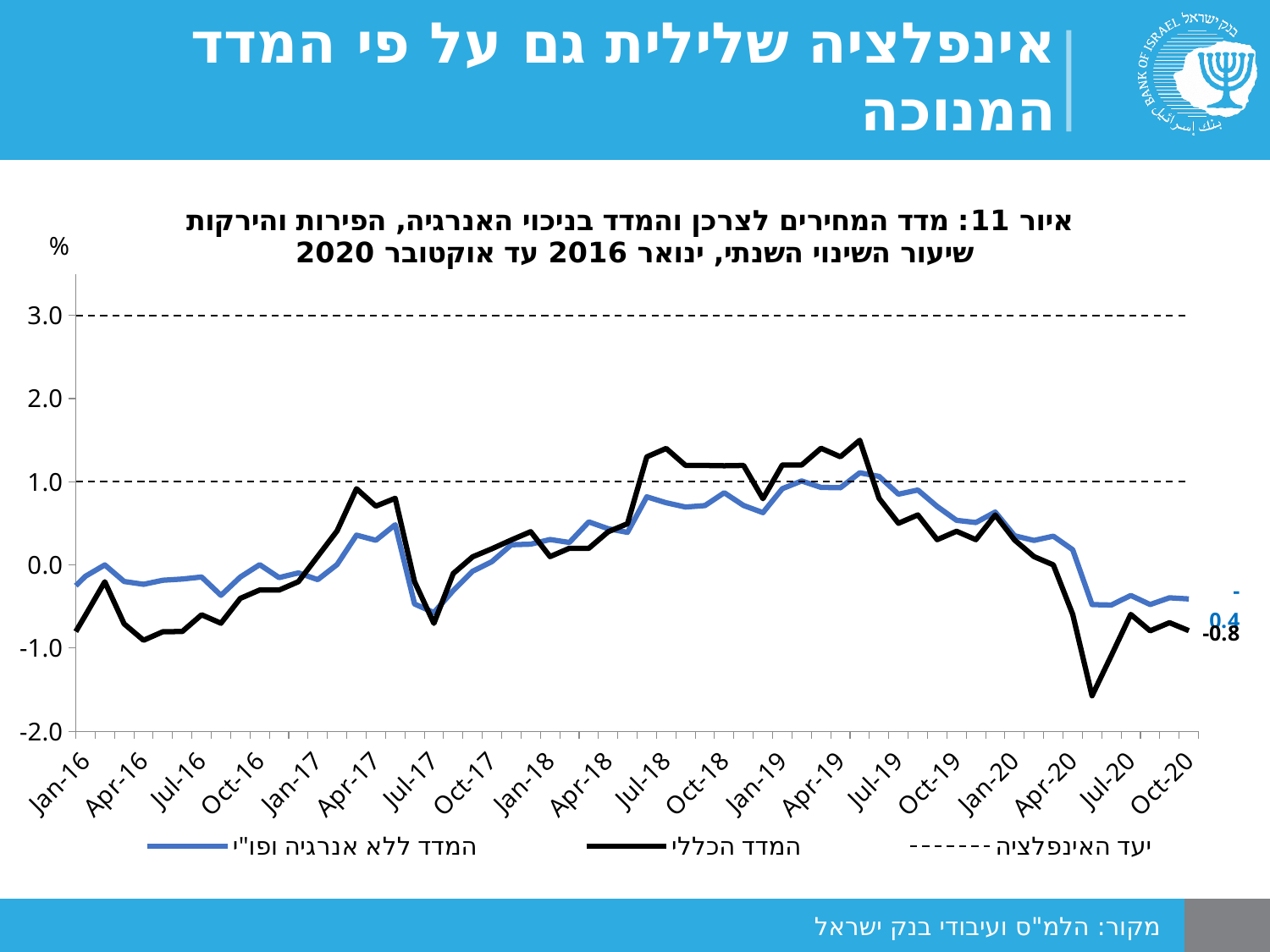
Between Jul-19 and Apr-20, does המדד הכללי generally rise or fall? fall What do the dashed horizontal lines at 1.0 and 3.0 represent, according to the legend? יעד האינפלציה What is the last labelled value of המדד ללא אנרגיה ופו"י (October 2020)? -0.4 What is the difference between the final labelled values of המדד ללא אנרגיה ופו"י (-0.4) and המדד הכללי (-0.8)? 0.4 What is the last labelled value of המדד הכללי (October 2020)? -0.8 Which series reaches the lowest value on the chart? המדד הכללי Is the value of המדד הכללי in Jan-16 greater or less than 0.0? less How many entries does the legend list? 3 At the end of the series (October 2020), which is higher: המדד הכללי or המדד ללא אנרגיה ופו"י? המדד ללא אנרגיה ופו"י Is the lowest point of המדד הכללי (around spring 2020) greater or less than -1.0? less Is the value of המדד הכללי in Jul-18 greater or less than 1.0? greater What type of chart is shown on the slide? line chart